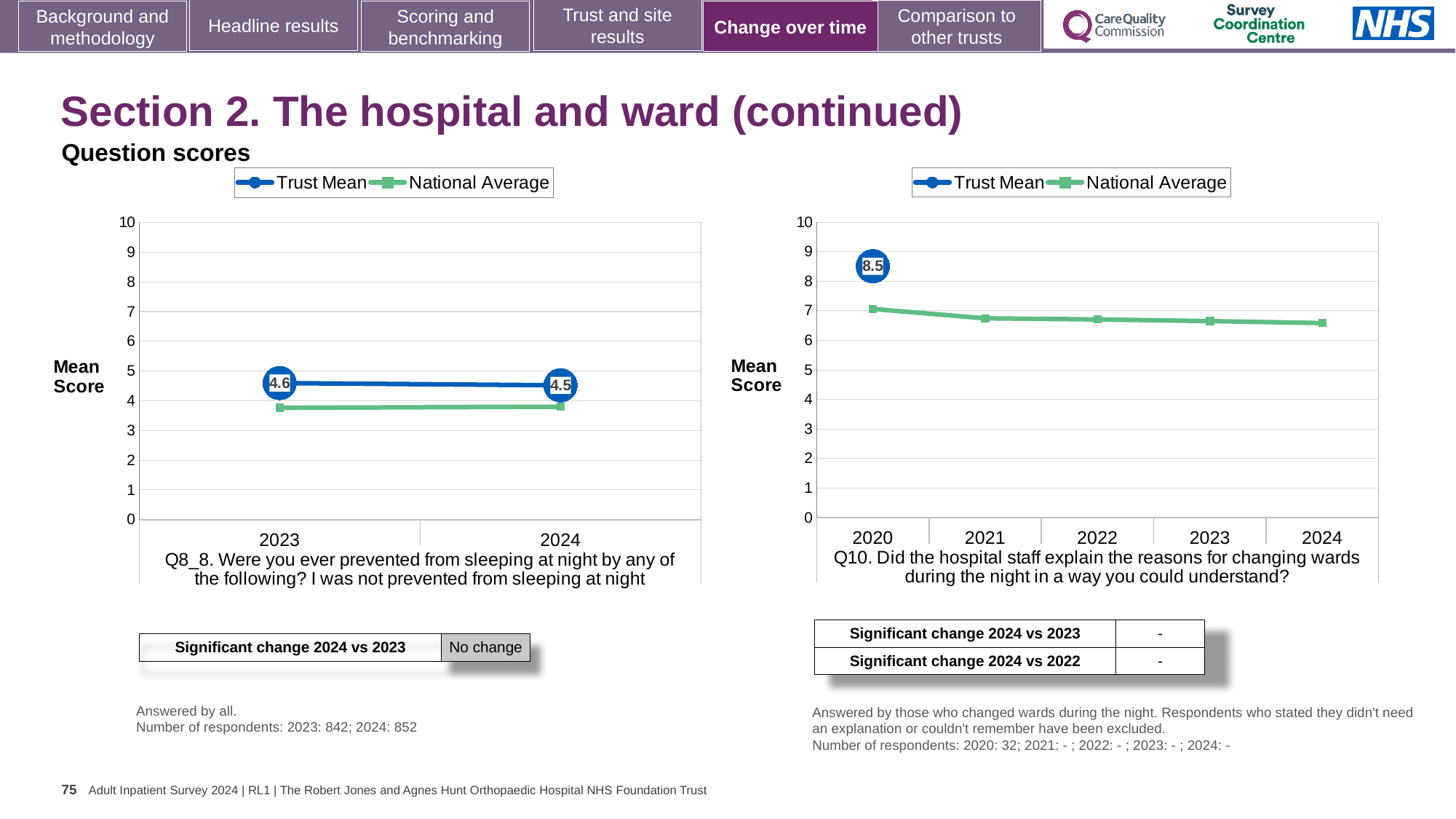
In the left chart (Q8_8), is the National Average for 2024 greater or less than 4? less In the right chart (Q10), what is the Trust Mean for 2020? 8.5 In the left chart (Q8_8), what is the Trust Mean for 2023? 4.6 In the left chart (Q8_8), does the Trust Mean rise or fall from 2023 to 2024? fall In the right chart (Q10), is the National Average for 2020 greater or less than 6? greater In the left chart (Q8_8), what is the Trust Mean for 2024? 4.5 In the left chart (Q8_8), what is the difference between the Trust Mean for 2023 and 2024? 0.1 What kind of chart is the right chart (Q10)? line chart In the left chart (Q8_8), which series is higher in 2023, Trust Mean or National Average? Trust Mean How many years are shown on the x axis of the right chart (Q10)? 5 How many series does the legend of the left chart (Q8_8) list? 2 In the right chart (Q10), does the National Average rise or fall from 2020 to 2024? fall